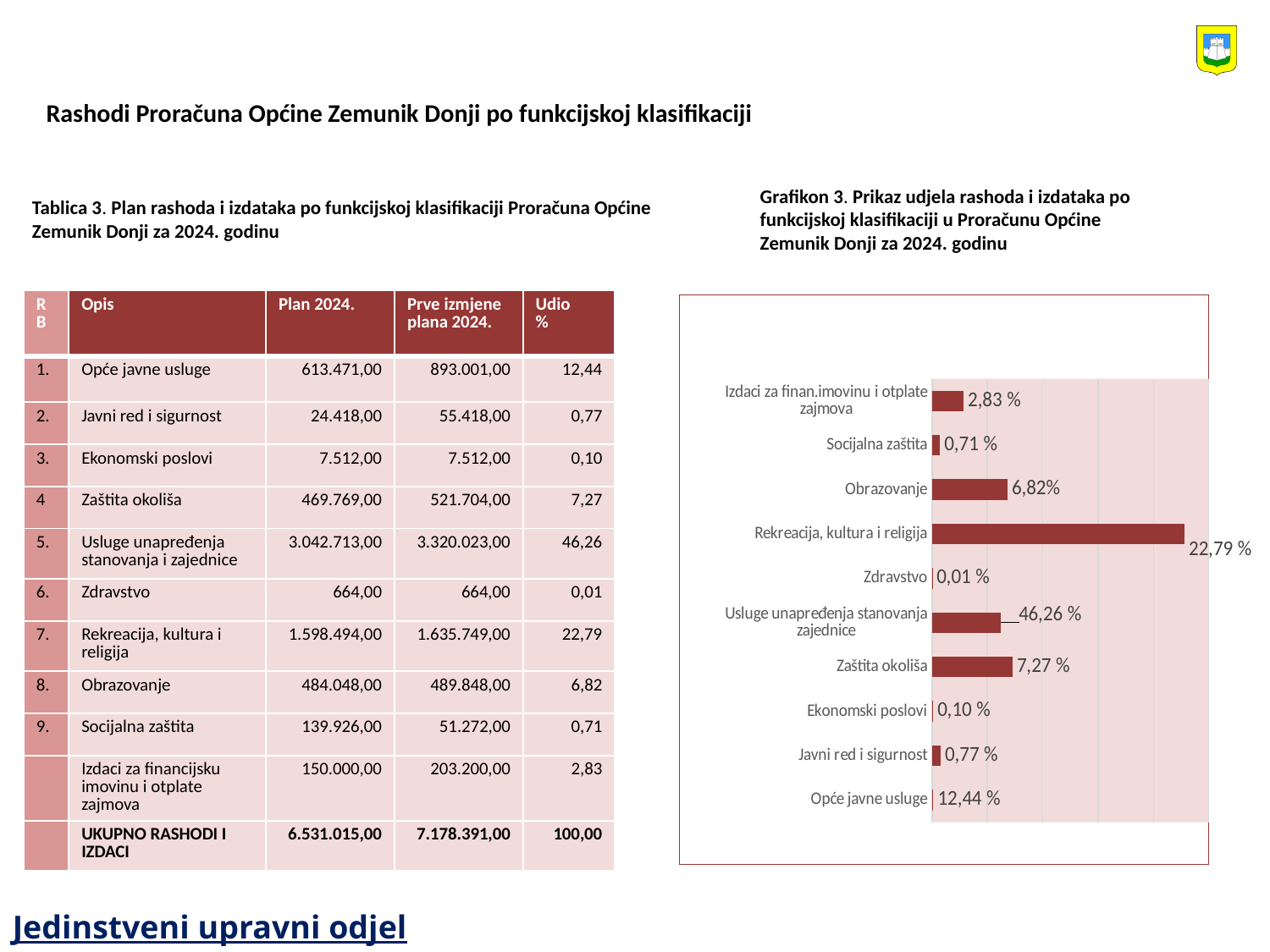
What is the value shown for Zaštita okoliša in the chart? 7,27 % What is the value shown for Opće javne usluge in the chart? 12,44 % What is the value shown for Rekreacija, kultura i religija in the chart? 22,79 % What is the difference between the labelled values for Zaštita okoliša and Obrazovanje? 0,45 % What is the value shown for Izdaci za finan.imovinu i otplate zajmova in the chart? 2,83 % What is the value shown for Obrazovanje in the chart? 6,82% What kind of chart is shown on the slide? bar chart What is the difference between the labelled values for Rekreacija, kultura i religija and Opće javne usluge? 10,35 % How many categories are plotted in the chart? 10 What is the value shown for Usluge unapređenja stanovanja zajednice in the chart? 46,26 % What is the title of the chart on the slide? Grafikon 3. Prikaz udjela rashoda i izdataka po funkcijskoj klasifikaciji u Proračunu Općine Zemunik Donji za 2024. godinu What is the value shown for Zdravstvo in the chart? 0,01 %